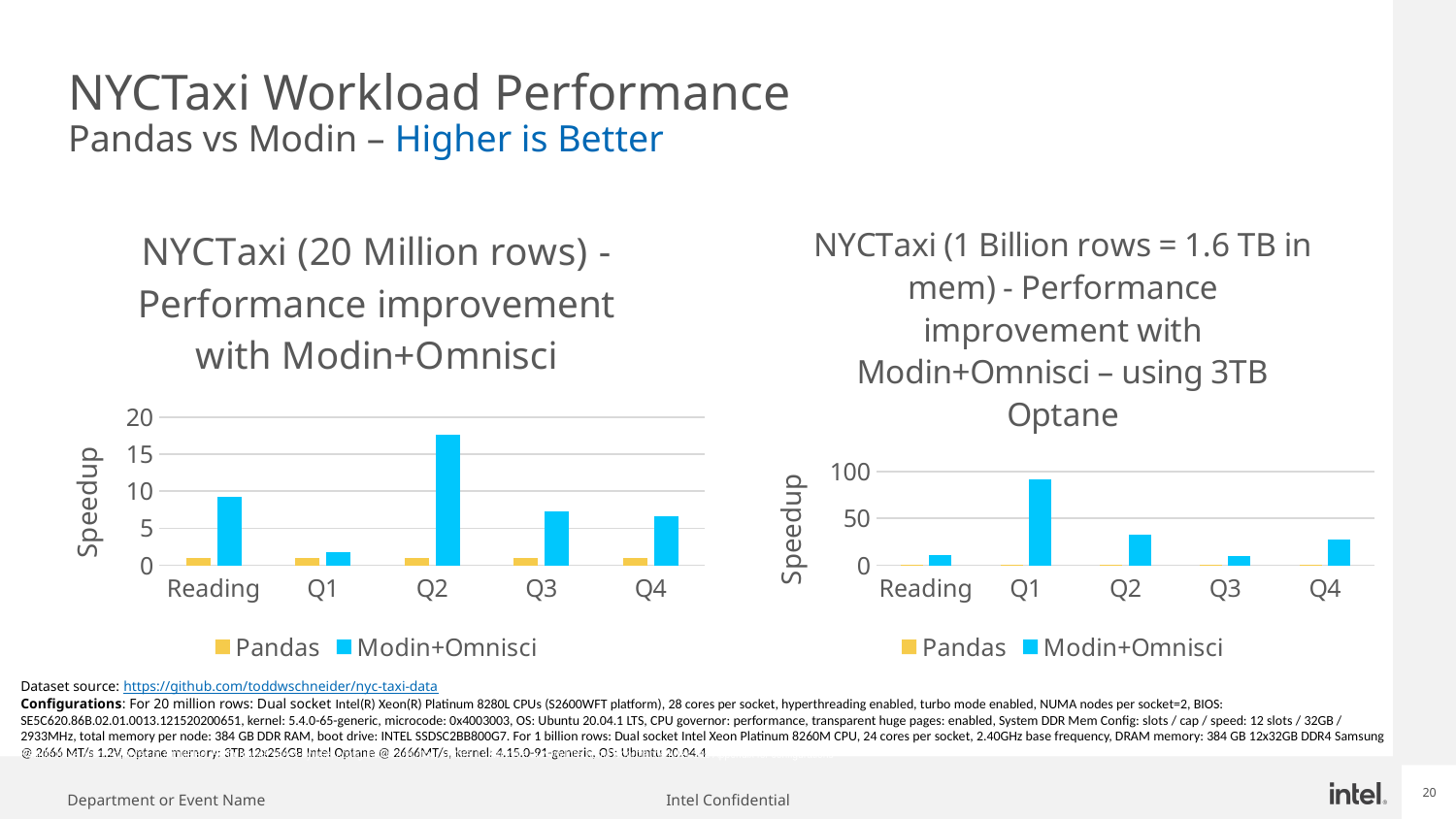
In the right chart (1 Billion rows), is the Modin+Omnisci speedup for Q2 greater or less than 50? less How many series does the legend of the right chart (1 Billion rows) list? 2 In the left chart (20 Million rows), which category has the lowest Modin+Omnisci speedup? Q1 In the left chart (20 Million rows), which is larger: the Modin+Omnisci speedup for Reading or for Q3? Reading How many categories are shown on the x axis of the left chart (20 Million rows)? 5 In the right chart (1 Billion rows), which is larger: the Modin+Omnisci speedup for Q2 or for Q3? Q2 What is the label on the y axis of the right chart (1 Billion rows)? Speedup What kind of chart is the left chart, 'NYCTaxi (20 Million rows) - Performance improvement with Modin+Omnisci'? bar chart In the right chart (1 Billion rows), which category has the highest Modin+Omnisci speedup? Q1 In the left chart (20 Million rows), is the Modin+Omnisci speedup for Q2 greater or less than 15? greater In the left chart (20 Million rows), which category has the highest Modin+Omnisci speedup? Q2